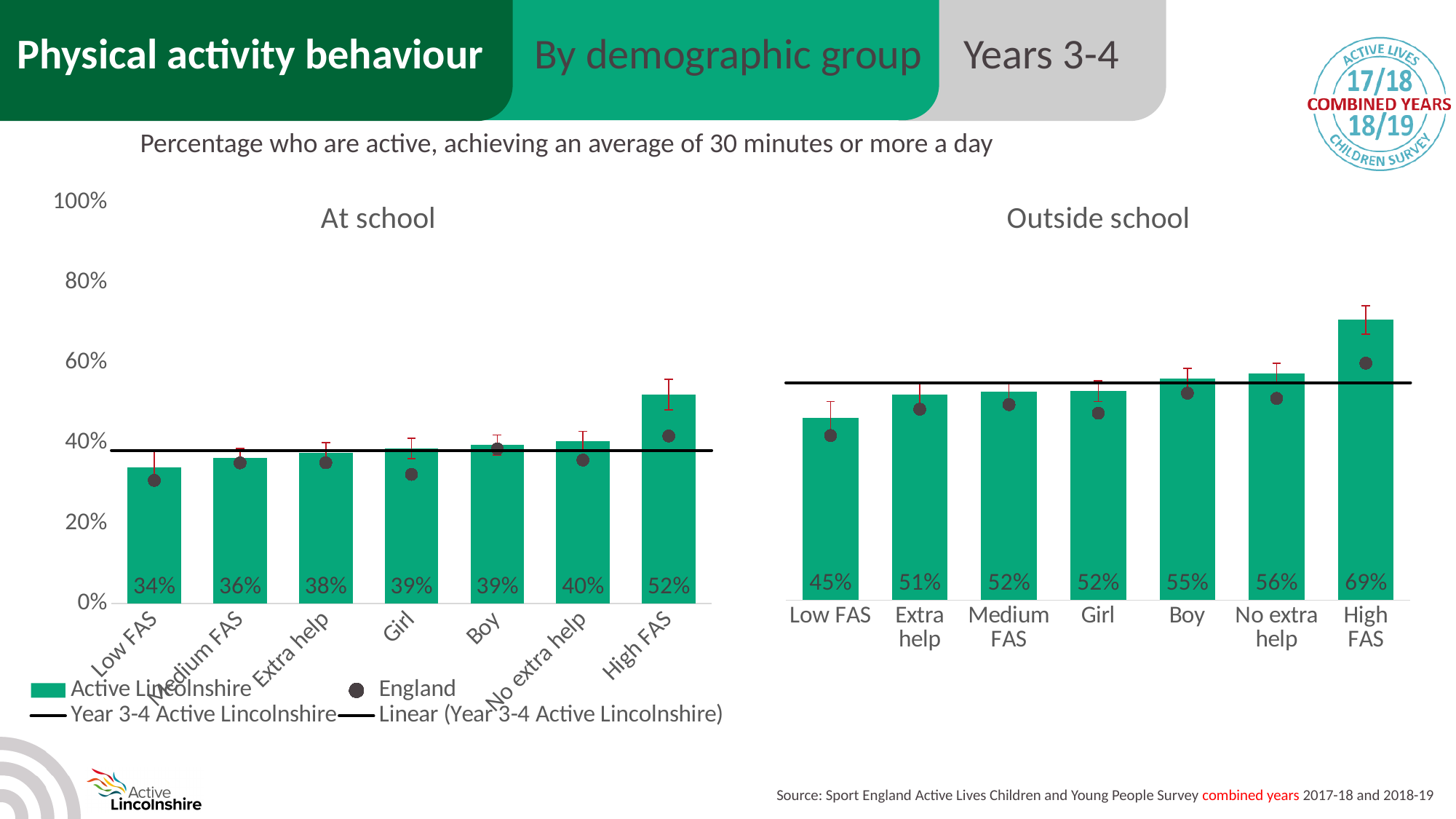
In the 'Outside school' chart, which category has the lowest Active Lincolnshire value? Low FAS How many entries does the legend list? 4 In the 'Outside school' chart, what is the difference between the High FAS and Boy Active Lincolnshire values? 14% In the 'At school' chart, which category has the highest Active Lincolnshire value? High FAS What type of chart is the 'At school' chart? combination bar and line chart How many categories are shown in the 'Outside school' chart? 7 In the 'Outside school' chart, which is larger for Active Lincolnshire: Extra help or Boy? Boy In the 'Outside school' chart, do the Active Lincolnshire values rise or fall from Low FAS to High FAS? rise In the 'At school' chart, is the Active Lincolnshire value for High FAS greater or less than 40%? greater In the 'At school' chart, what is the difference between the High FAS and Low FAS Active Lincolnshire values? 18% In the 'At school' chart, what is the Active Lincolnshire value for Low FAS? 34% In the 'Outside school' chart, what is the Active Lincolnshire value for No extra help? 56%